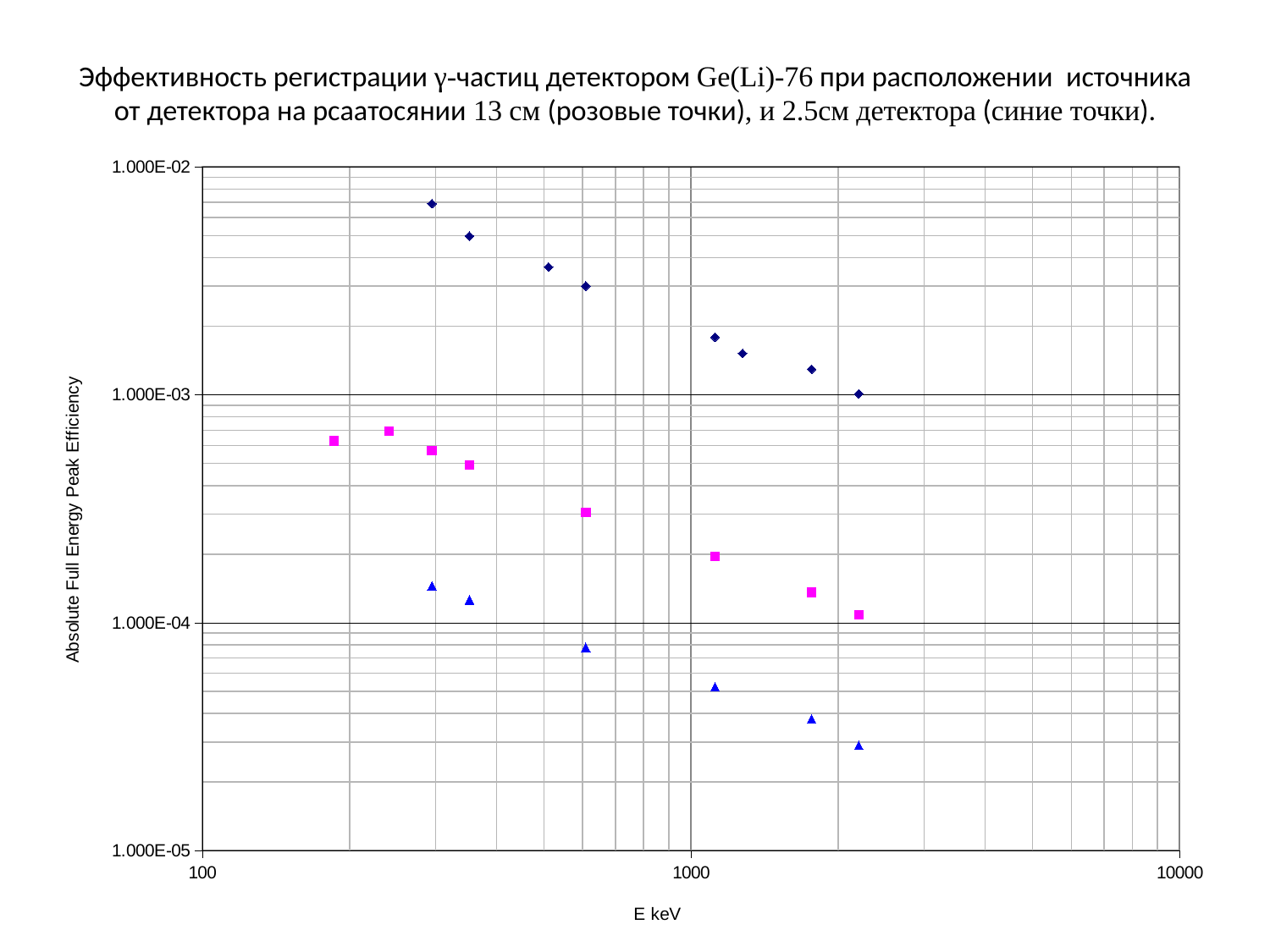
Near 660 keV, which point has the larger value: the blue diamond or the pink square? the blue diamond How many pink square points are plotted on the chart? 8 Do the plotted efficiency values rise or fall as the energy increases along the x axis? fall Is the value of the pink square point near 1100 keV greater or less than 1.000E-04? greater Is the value of the blue triangle point near 1100 keV greater or less than 1.000E-04? less What is the title of the horizontal axis? E keV Is the value of the pink square point near 250 keV greater or less than 1.000E-03? less Which marker series contains the lowest plotted point on the chart? the blue triangles What kind of chart is shown on the slide? scatter chart What is the title of the vertical axis? Absolute Full Energy Peak Efficiency Which marker series contains the highest plotted point on the chart? the blue diamonds